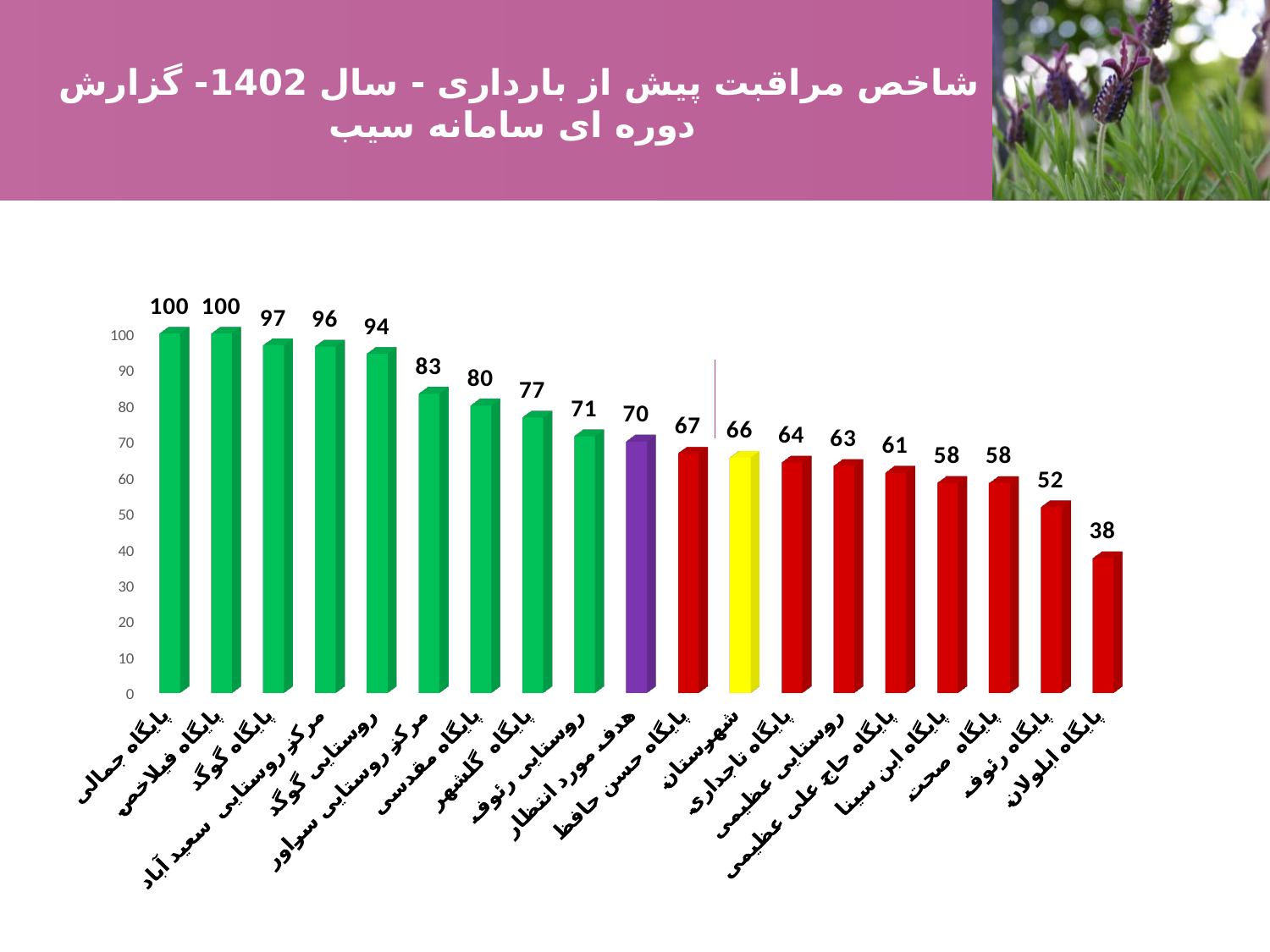
How many bars are in the chart? 19 What is the value for پایگاه گوگد? 97 What is the difference between the values for پایگاه مقدسی and پایگاه رئوف? 28 What is the value for هدف مورد انتظار? 70 Do the values rise or fall from left to right along the x axis? fall Which is larger, the value for روستایی گوگد or the value for مرکز روستایی سراور? روستایی گوگد What is the highest value shown in the chart? 100 What is the value for پایگاه ابلولان? 38 What type of chart is shown on the slide? bar chart Which category has the lowest value? پایگاه ابلولان What colour is the bar for شهرستان? yellow What is the value for شهرستان? 66